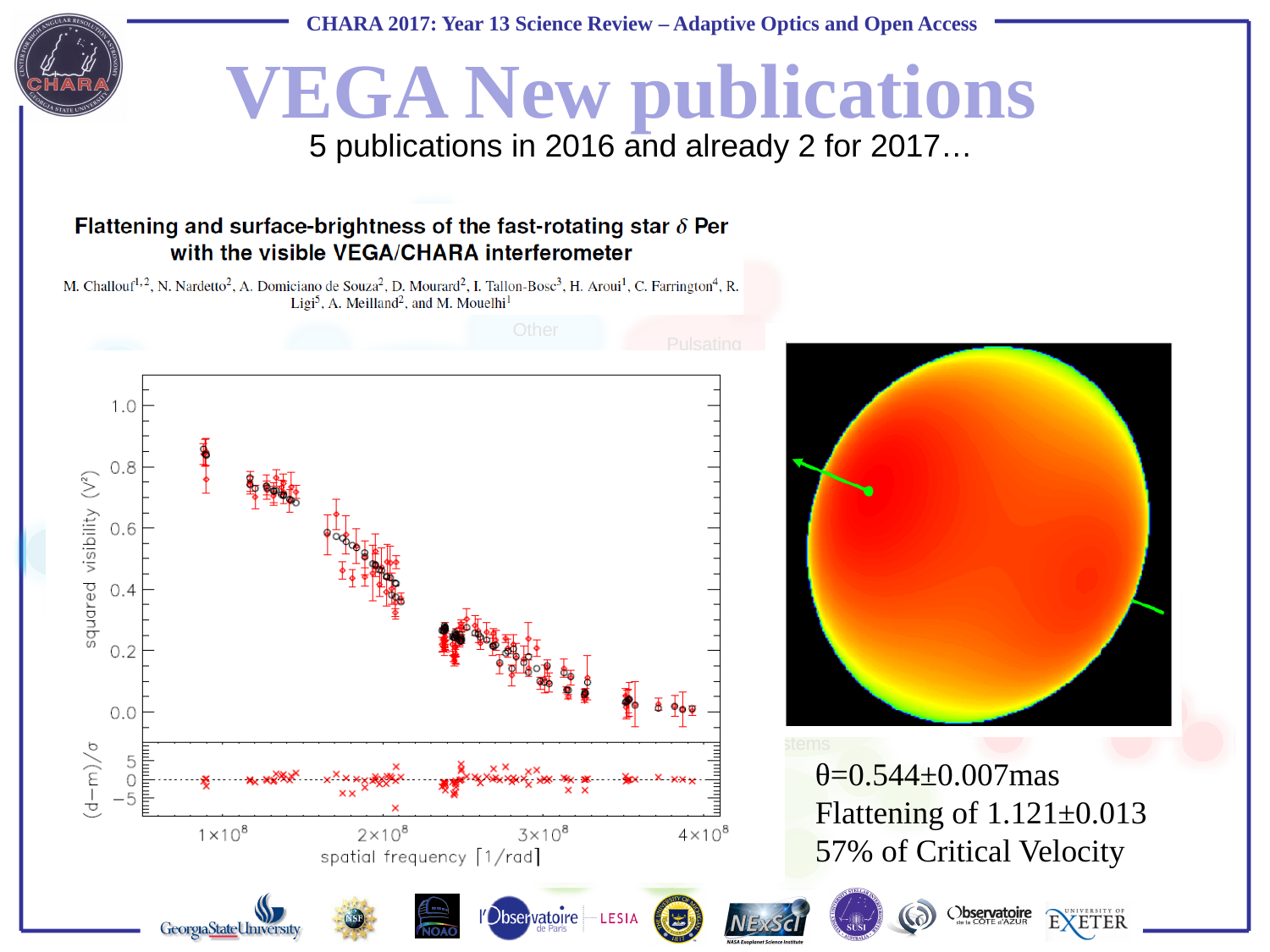
In the squared visibility chart, is the value at a spatial frequency of about 2×10^8 greater or less than 0.2? greater In the squared visibility chart, do the values rise or fall as spatial frequency increases? fall In the squared visibility chart, which has the higher squared visibility: the points near 1×10^8 or the points near 3×10^8? the points near 1×10^8 What kind of chart is the plot of squared visibility against spatial frequency? scatter plot In the squared visibility chart, is the value at a spatial frequency of about 3×10^8 greater or less than 0.4? less In the squared visibility chart, is the value at a spatial frequency of about 1×10^8 greater or less than 0.6? greater What is the label of the x axis of the chart? spatial frequency [1/rad] What is the label of the y axis of the main panel of the chart? squared visibility (V²) What is the highest tick value shown on the y axis of the main panel of the chart? 1.0